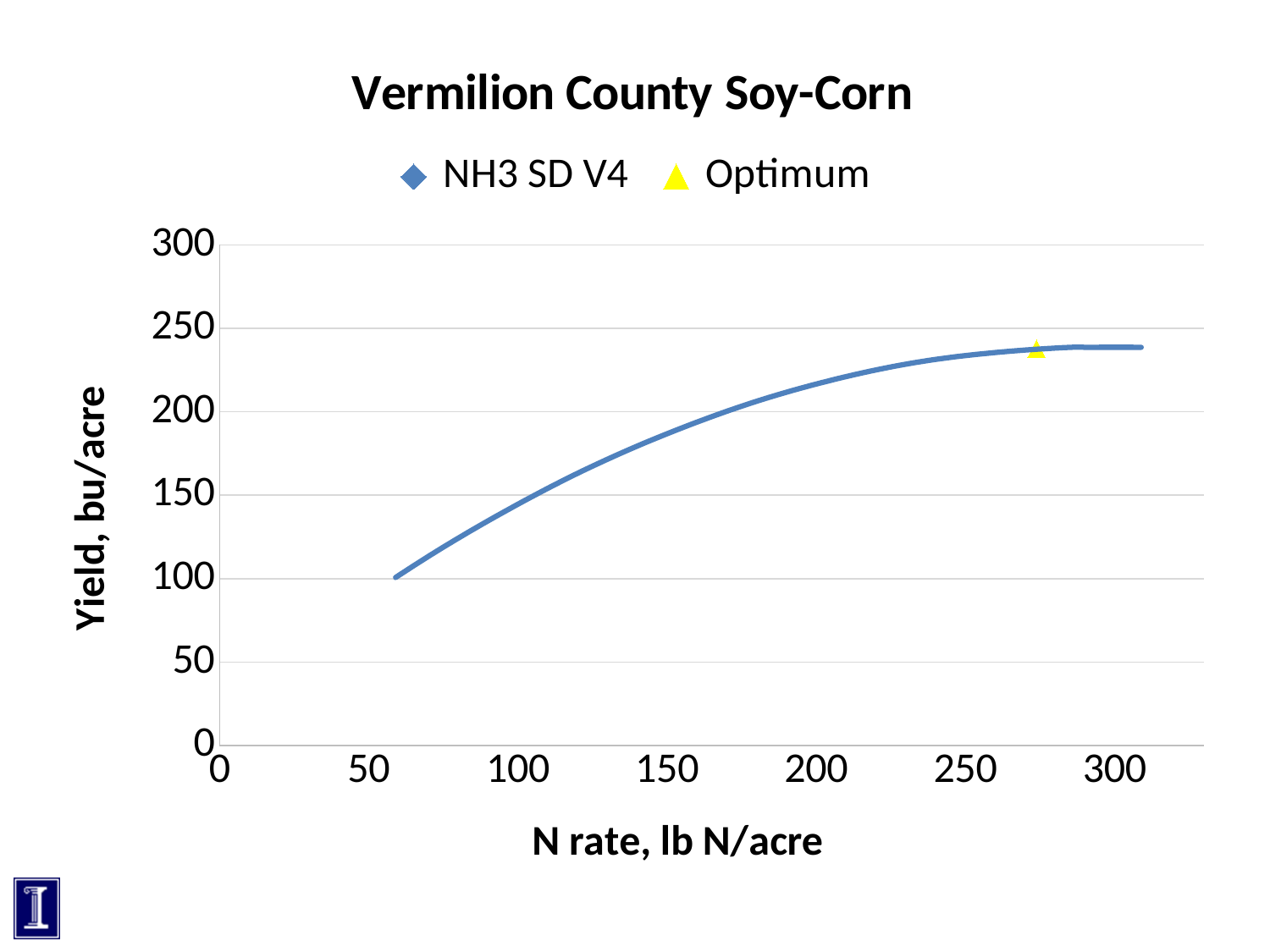
What are the two series named in the legend? NH3 SD V4 and Optimum Is the highest yield reached by the NH3 SD V4 curve greater or less than 250 bu/acre? less Is the N rate at the Optimum point greater or less than 250 lb N/acre? greater How many series does the legend list? 2 What is the title of the chart? Vermilion County Soy-Corn What kind of chart is shown on the slide? line chart Is the NH3 SD V4 yield at an N rate of 200 lb N/acre greater or less than 200 bu/acre? greater Does the NH3 SD V4 yield rise or fall as the N rate increases along the x axis? rise